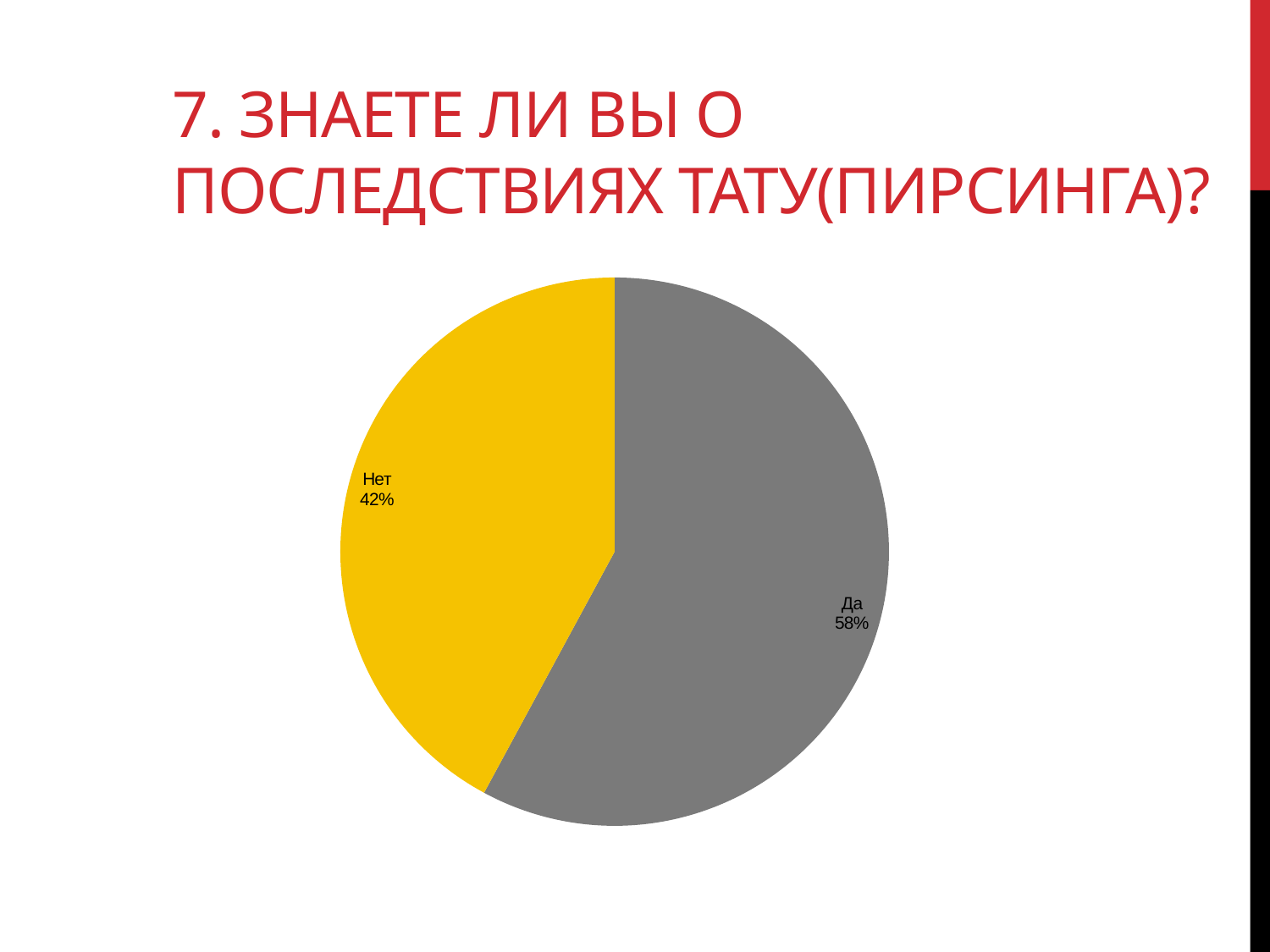
What colour is the "Да" slice? grey What kind of chart is shown on the slide? pie chart Which slice is larger, "Да" or "Нет"? Да How many slices does the pie chart have? 2 What share of the pie does the "Да" slice represent? 58% What is the difference in percentage points between the "Да" and "Нет" slices? 16 Which slice is the largest in the pie chart? Да Which slice is the smallest in the pie chart? Нет What share of the pie does the "Нет" slice represent? 42% What colour is the "Нет" slice? yellow